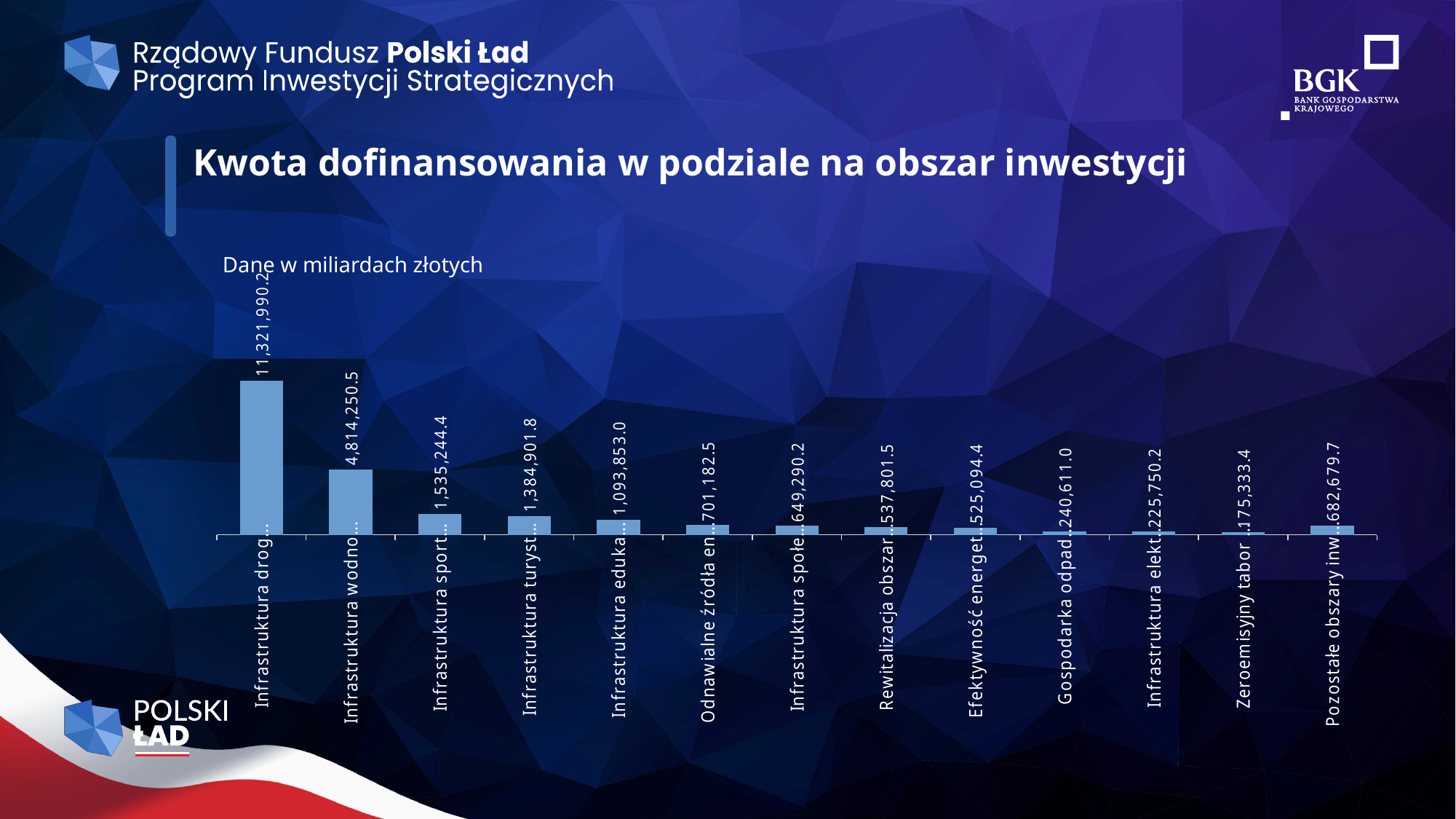
Which category has the highest value in the chart? Infrastruktura drog... What is the value shown for the category labelled 'Pozostałe obszary inw...'? 682,679.7 What is the value shown for the category labelled 'Infrastruktura drog...'? 11,321,990.2 How many categories (bars) does the chart show? 13 What type of chart is shown on the slide? bar chart What is the title of the chart on the slide? Kwota dofinansowania w podziale na obszar inwestycji What unit note is printed above the chart? Dane w miliardach złotych What is the value shown for the category labelled 'Odnawialne źródła en...'? 701,182.5 Which has the larger value: 'Gospodarka odpad...' or 'Infrastruktura elekt...'? Gospodarka odpad... Which category has the lowest value in the chart? Zeroemisyjny tabor... What is the difference between the values for 'Infrastruktura wodno...' and 'Infrastruktura sport...'? 3,279,006.1 What is the value shown for the category labelled 'Infrastruktura wodno...'? 4,814,250.5